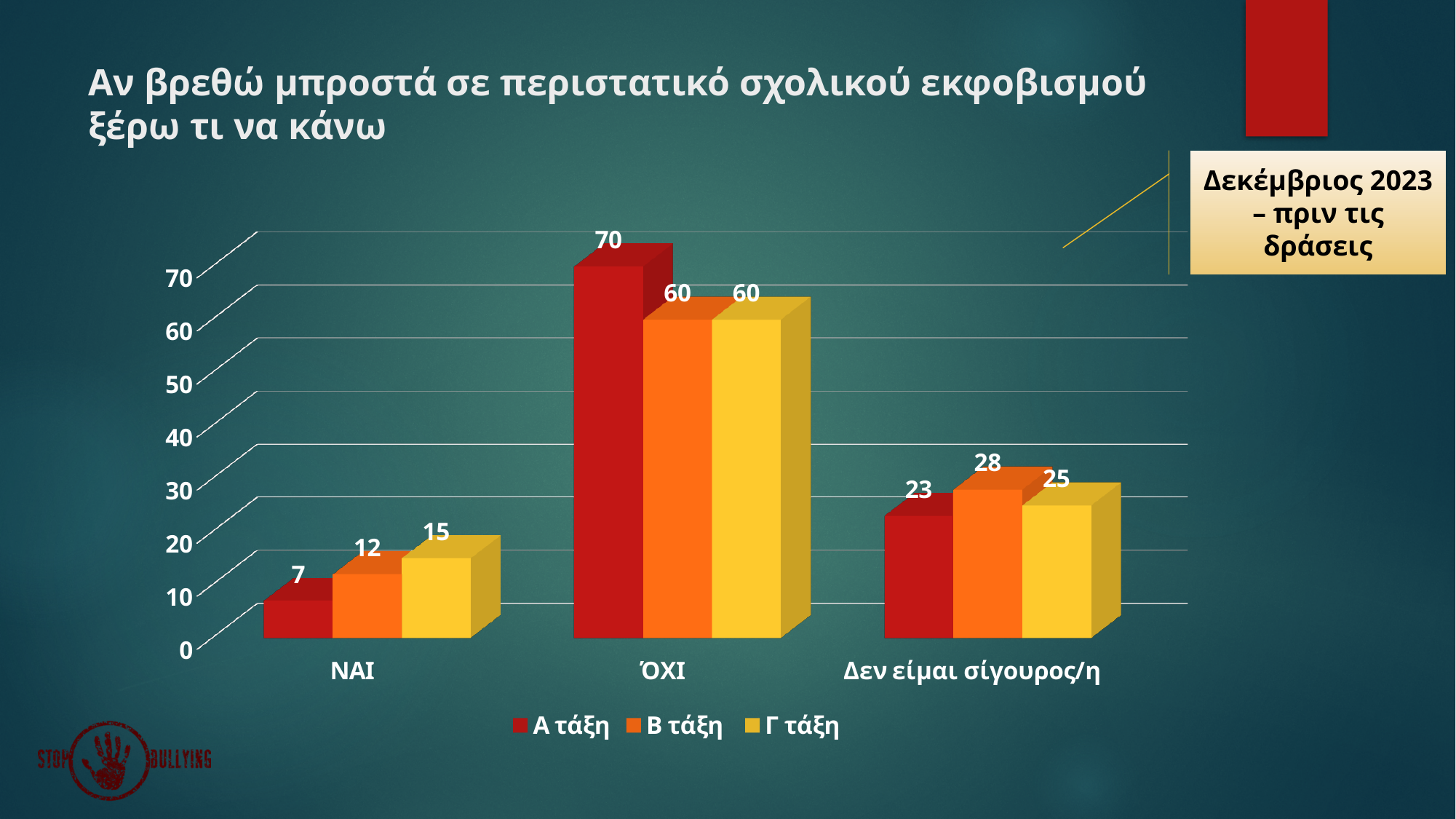
What is the value for Α τάξη in the ΌΧΙ category? 70 What is the difference between the Γ τάξη and Α τάξη values in the ΝΑΙ category? 8 Which category has the highest value for Α τάξη? ΌΧΙ What is the value for Β τάξη in the Δεν είμαι σίγουρος/η category? 28 What is the difference between the Α τάξη and Β τάξη values in the ΌΧΙ category? 10 How many categories are shown on the x axis? 3 How many series does the legend list? 3 What kind of chart is shown on the slide? bar chart Which series is shown in red in the legend? Α τάξη What is the value for Γ τάξη in the ΝΑΙ category? 15 Which category has the lowest value for Β τάξη? ΝΑΙ Which is larger in the Δεν είμαι σίγουρος/η category: Α τάξη or Γ τάξη? Γ τάξη